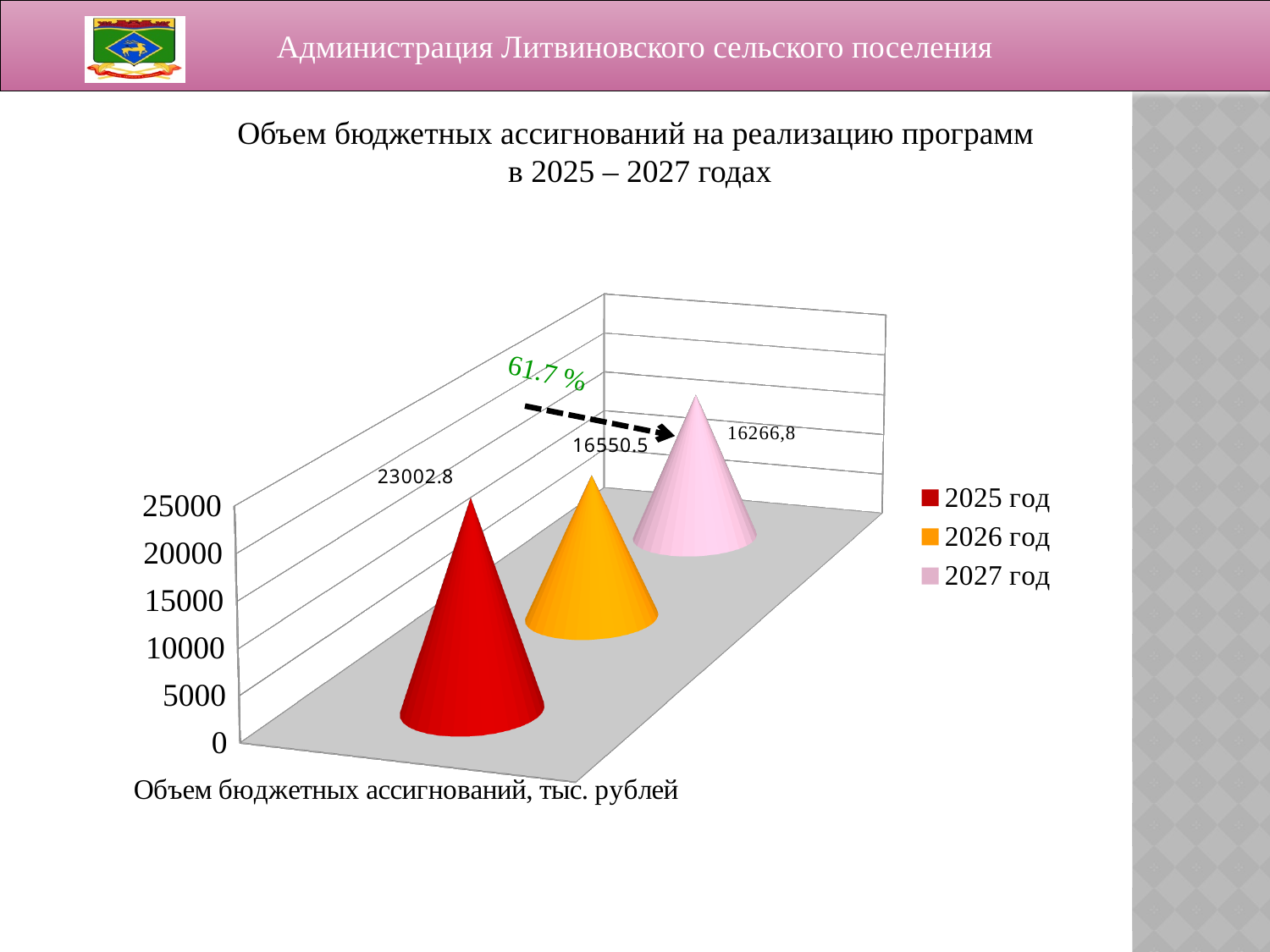
Which is larger, the value for 2026 год or the value for 2027 год? 2026 год Which year has the highest budget allocation? 2025 год What is the value for 2027 год? 16266,8 What is the difference between the values for 2026 год and 2027 год? 283.7 Do the values rise or fall from 2025 to 2027? fall What percentage is written next to the arrow on the chart? 61.7 % What is the difference between the values for 2025 год and 2026 год? 6452.3 Is the value for 2025 год greater or less than 20000? greater Which year has the lowest budget allocation? 2027 год How many series does the legend list? 3 What is the value for 2026 год? 16550.5 What is the value for 2025 год? 23002.8